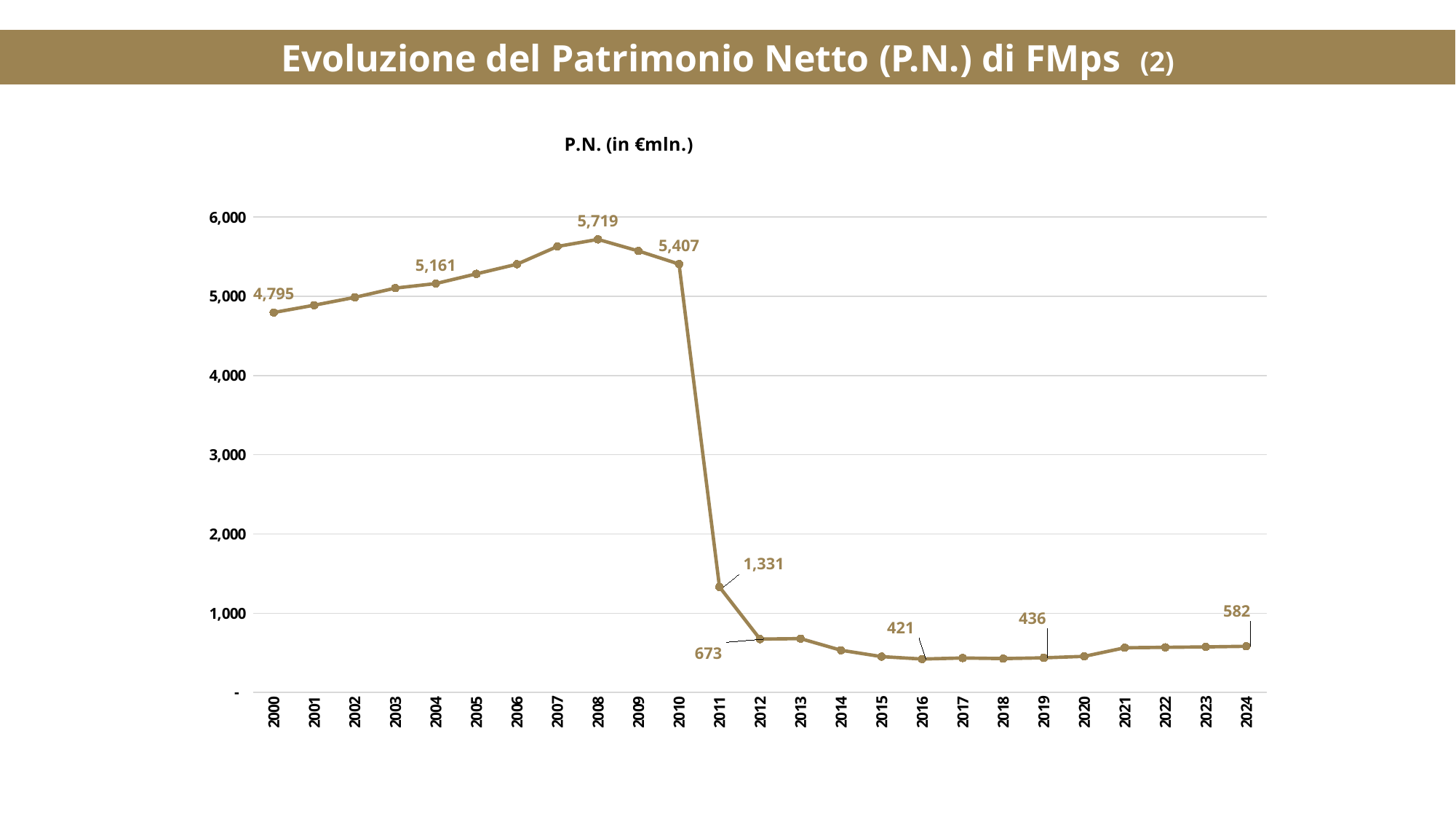
Which year has the lowest P.N. value? 2016 Which year has the highest P.N. value? 2008 How many years are plotted on the x axis? 25 Which is larger, the P.N. value for 2016 or for 2019? 2019 What type of chart is shown on the slide? line chart What is the title shown above the chart? P.N. (in €mln.) What is the P.N. value for 2000? 4,795 What is the P.N. value for 2011? 1,331 What is the P.N. value for 2008? 5,719 What is the P.N. value for 2024? 582 What is the difference between the P.N. value in 2010 and in 2011? 4,076 Is the value for 2014 greater or less than 1,000? less